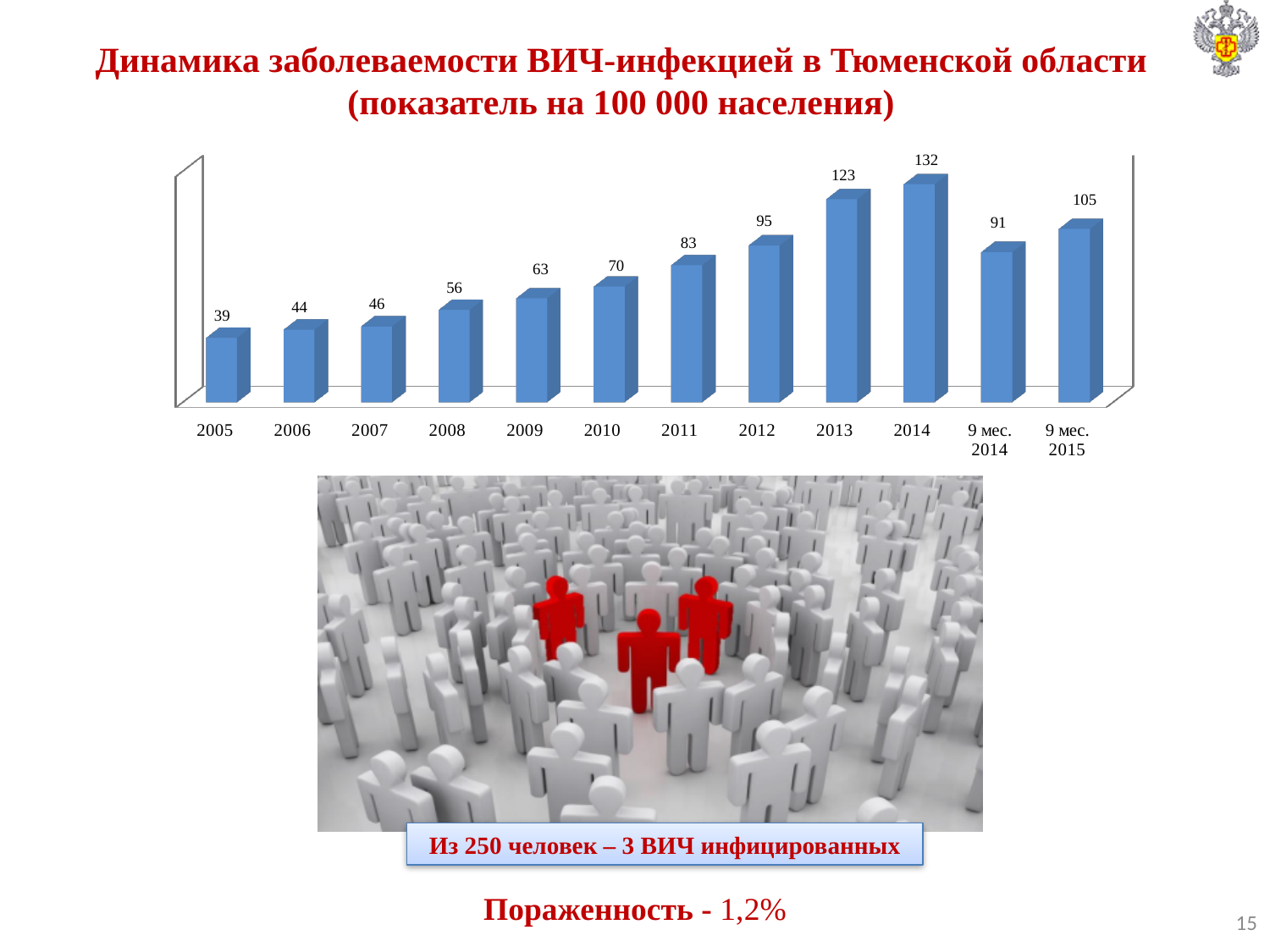
What is the difference between the values for 9 мес. 2015 and 9 мес. 2014? 14 What is the title of the slide above the chart? Динамика заболеваемости ВИЧ-инфекцией в Тюменской области (показатель на 100 000 населения) What is the value for 2005? 39 Do the values rise or fall from 2005 to 2014? rise What kind of chart is shown on the slide? bar chart What is the value for 2011? 83 Which category has the lowest value? 2005 Which category has the highest value? 2014 How many categories are shown on the x axis? 12 What is the difference between the values for 2014 and 2013? 9 Which is larger, the value for 2012 or the value for 9 мес. 2014? 2012 What is the value for 9 мес. 2015? 105